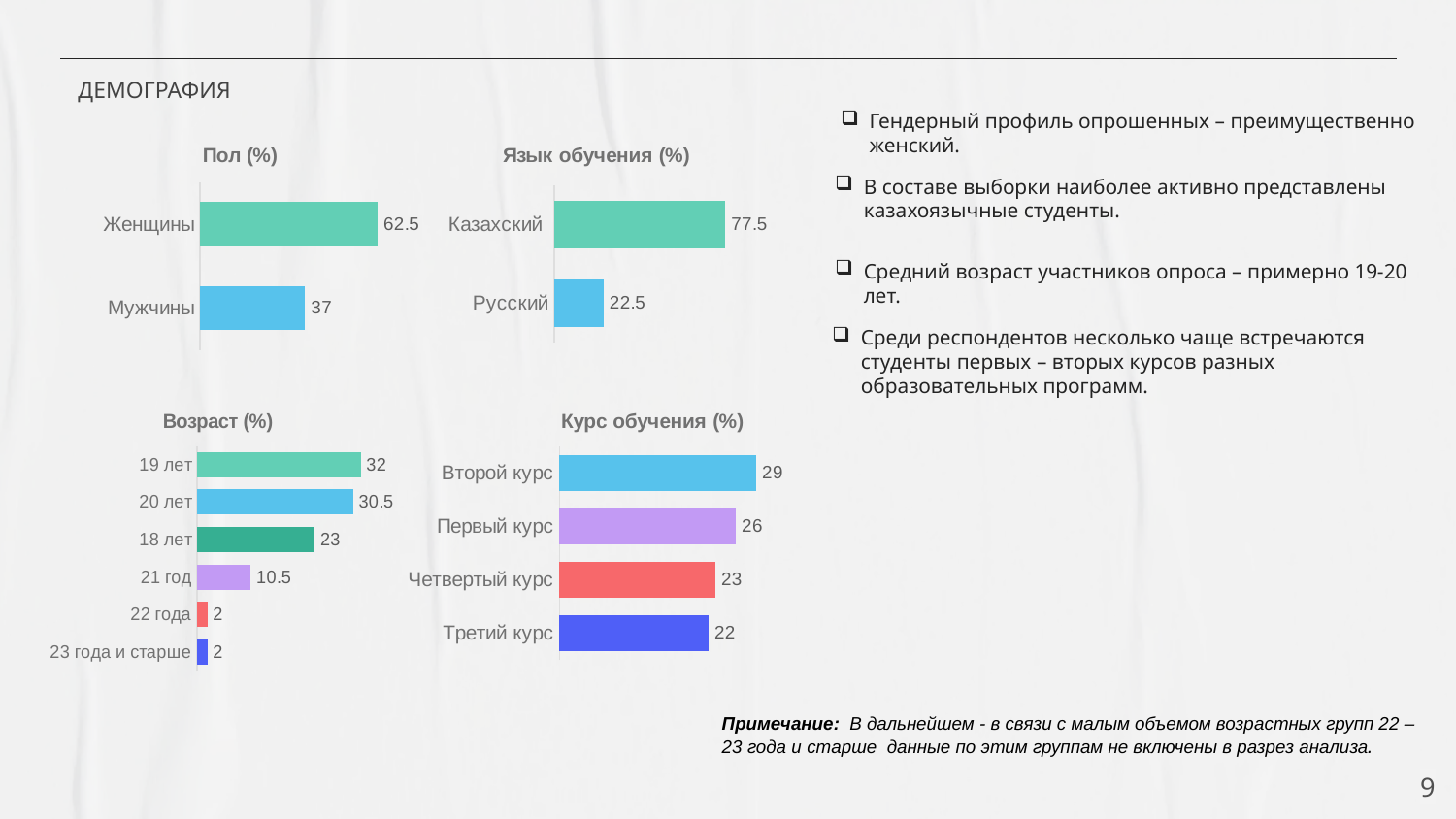
In the 'Возраст (%)' chart, how many categories are shown? 6 In the 'Язык обучения (%)' chart, what is the value for Русский? 22.5 In the 'Пол (%)' chart, what is the difference between the values for Женщины and Мужчины? 25.5 In the 'Возраст (%)' chart, what is the value for 21 год? 10.5 What type of chart is the 'Курс обучения (%)' chart? Bar chart In the 'Курс обучения (%)' chart, which category has the lowest value? Третий курс In the 'Курс обучения (%)' chart, which is larger: the value for Второй курс or Четвертый курс? Второй курс In the 'Возраст (%)' chart, which age group has the highest value? 19 лет In the 'Курс обучения (%)' chart, what is the value for Первый курс? 26 In the 'Возраст (%)' chart, what is the difference between the values for 19 лет and 20 лет? 1.5 In the 'Язык обучения (%)' chart, which category has the highest value? Казахский In the 'Пол (%)' chart, what is the value for Женщины? 62.5